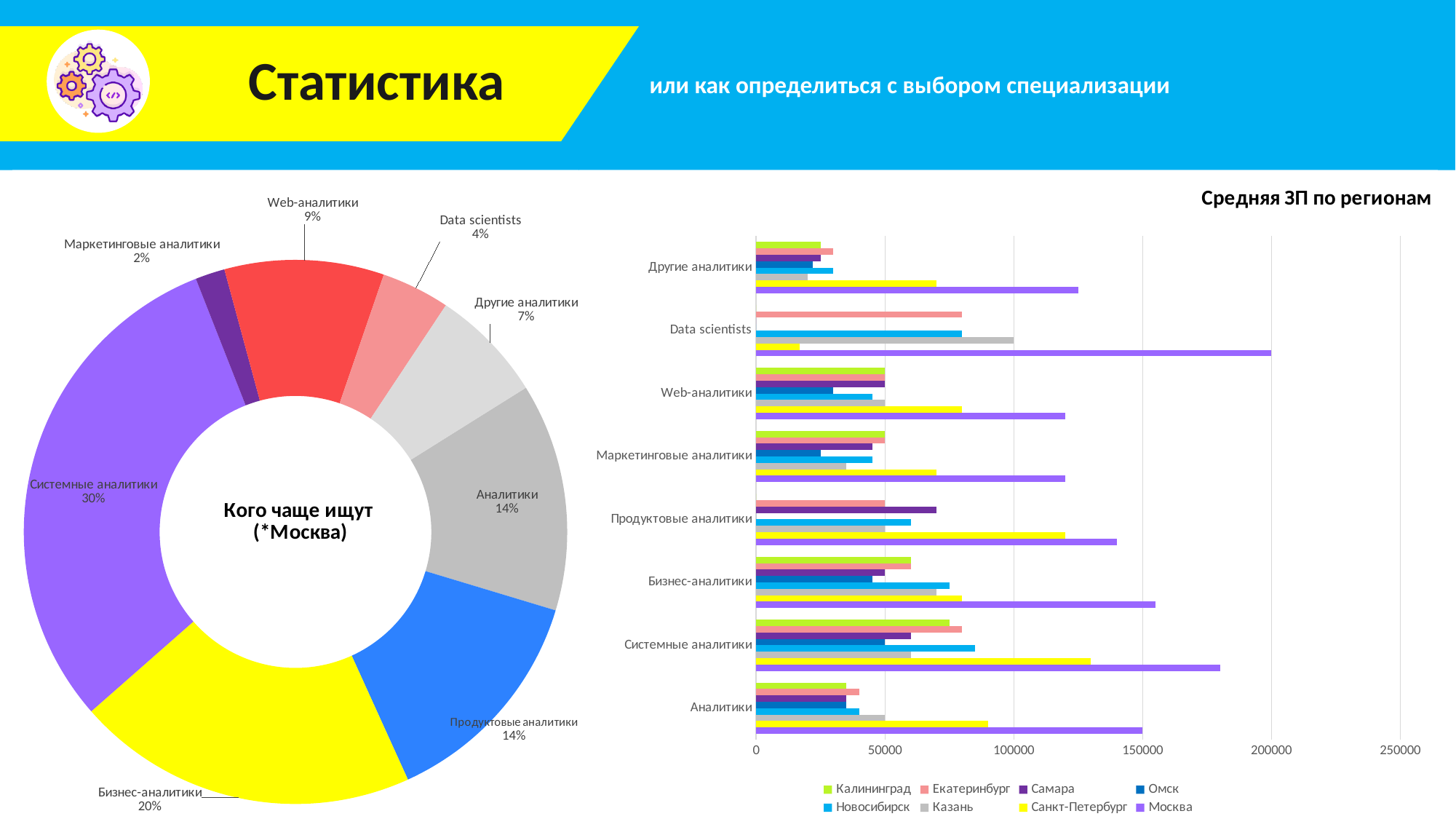
In the donut chart 'Кого чаще ищут (*Москва)', which category has the smallest share? Маркетинговые аналитики In the chart 'Средняя ЗП по регионам', is the value for Санкт-Петербург in Аналитики greater or less than 100000? less In the donut chart 'Кого чаще ищут (*Москва)', what share do Системные аналитики have? 30% In the donut chart 'Кого чаще ищут (*Москва)', which is larger: Бизнес-аналитики or Web-аналитики? Бизнес-аналитики In the chart 'Средняя ЗП по регионам', is the value for Москва in Системные аналитики greater or less than 150000? greater In the donut chart 'Кого чаще ищут (*Москва)', what is the difference in percentage points between Системные аналитики and Бизнес-аналитики? 10 In the chart 'Средняя ЗП по регионам', which region has the highest value for Data scientists? Москва How many categories does the donut chart 'Кого чаще ищут (*Москва)' show? 8 How many series does the legend of the chart 'Средняя ЗП по регионам' list? 8 What kind of chart is 'Средняя ЗП по регионам'? Bar chart In the donut chart 'Кого чаще ищут (*Москва)', which category has the largest share? Системные аналитики In the donut chart 'Кого чаще ищут (*Москва)', what share do Data scientists have? 4%